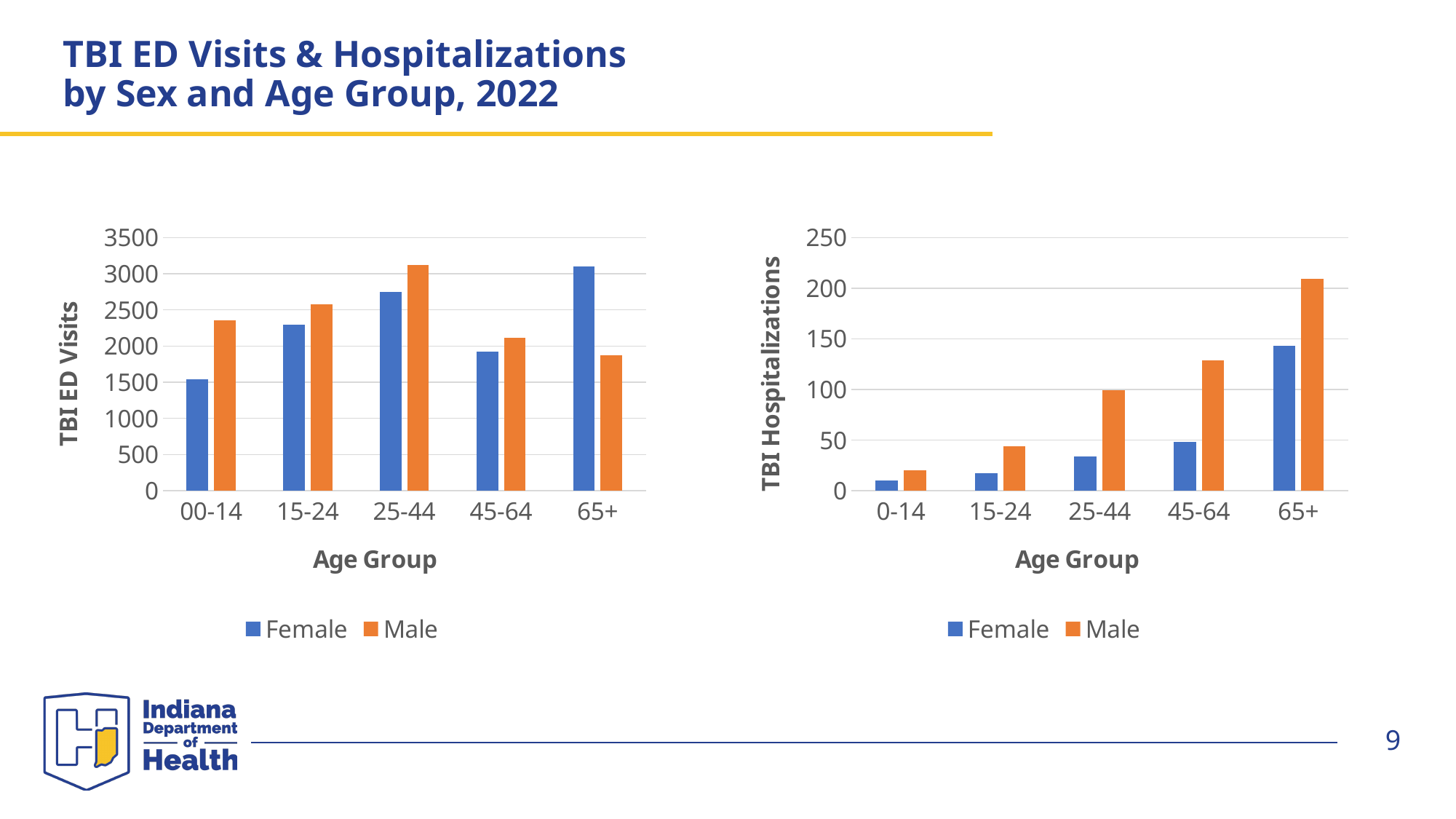
In the TBI ED Visits chart, is the Female value for 00-14 greater or less than 2000? less In the TBI ED Visits chart, for the 65+ age group, which is larger, Female or Male? Female In the TBI Hospitalizations chart, do the Male values rise or fall as age group increases? rise In the TBI ED Visits chart, which age group has the lowest Female value? 00-14 In the TBI ED Visits chart, which age group has the highest Male value? 25-44 In the TBI ED Visits chart, is the Male value for 25-44 greater or less than 3000? greater How many series does the legend of the TBI ED Visits chart list? 2 In the TBI ED Visits chart, which age group has the highest Female value? 65+ In the TBI Hospitalizations chart, is the Male value for 65+ greater or less than 150? greater How many age groups are shown on the x axis of the TBI Hospitalizations chart? 5 What type of chart is the left chart on the slide? bar chart In the TBI Hospitalizations chart, which age group has the highest Male value? 65+